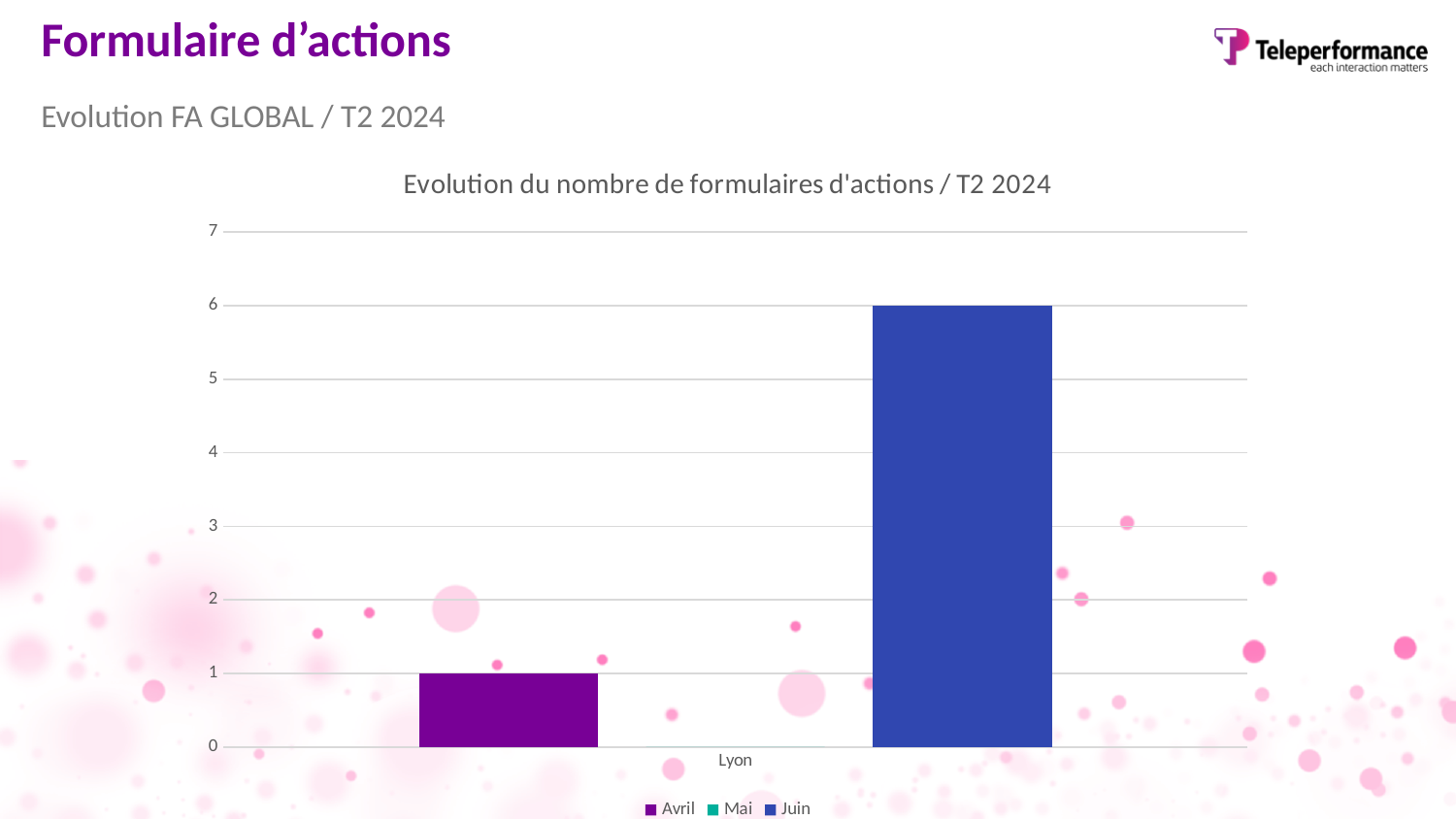
Is the value for Avril greater or less than 2? less What is the value for Avril in the chart? 1 What is the title of the chart? Evolution du nombre de formulaires d'actions / T2 2024 What is the difference between the Juin value and the Avril value? 5 Which month has the highest bar in the chart? Juin Is the value for Juin greater or less than 5? greater How many series does the legend list? 3 What kind of chart is shown on the slide? bar chart How many categories are shown on the x axis of the chart? 1 Which is larger, the value for Avril or the value for Juin? Juin What is the category label shown on the x axis? Lyon What is the value for Juin in the chart? 6